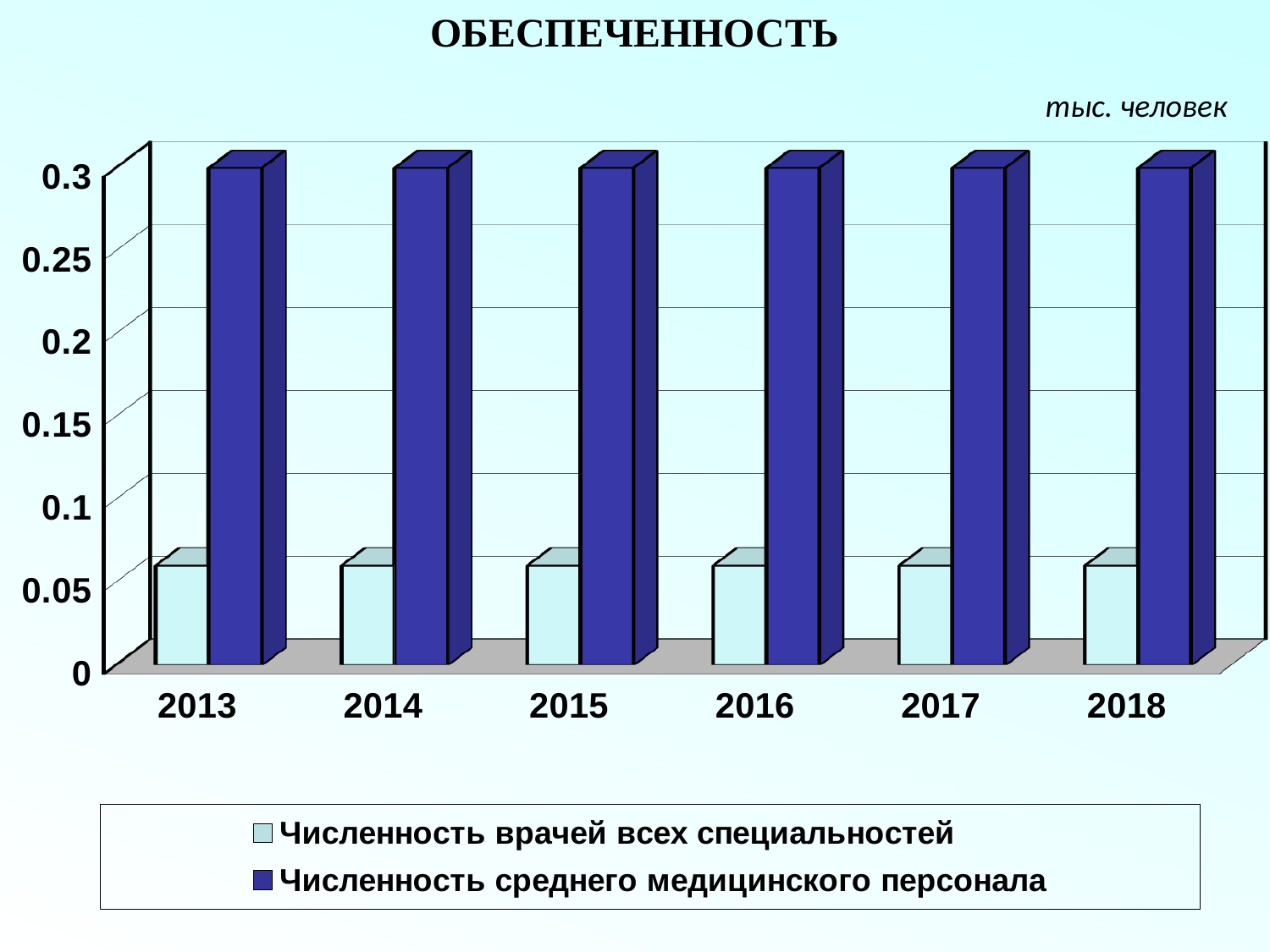
What is the title of the chart? ОБЕСПЕЧЕННОСТЬ What is the value for Численность среднего медицинского персонала in 2018? 0.3 Do the values for Численность среднего медицинского персонала rise, fall or stay the same from 2013 to 2018? stay the same How many series does the legend list? 2 Is the value for Численность врачей всех специальностей in 2013 greater or less than 0.1? less How many years are shown on the x axis of the chart? 6 In 2014, which series has the larger value? Численность среднего медицинского персонала What unit is indicated above the chart? тыс. человек Do the values for Численность врачей всех специальностей rise, fall or stay the same from 2013 to 2018? stay the same Is the value for Численность среднего медицинского персонала in 2016 greater or less than 0.25? greater What kind of chart is shown on the slide? bar chart